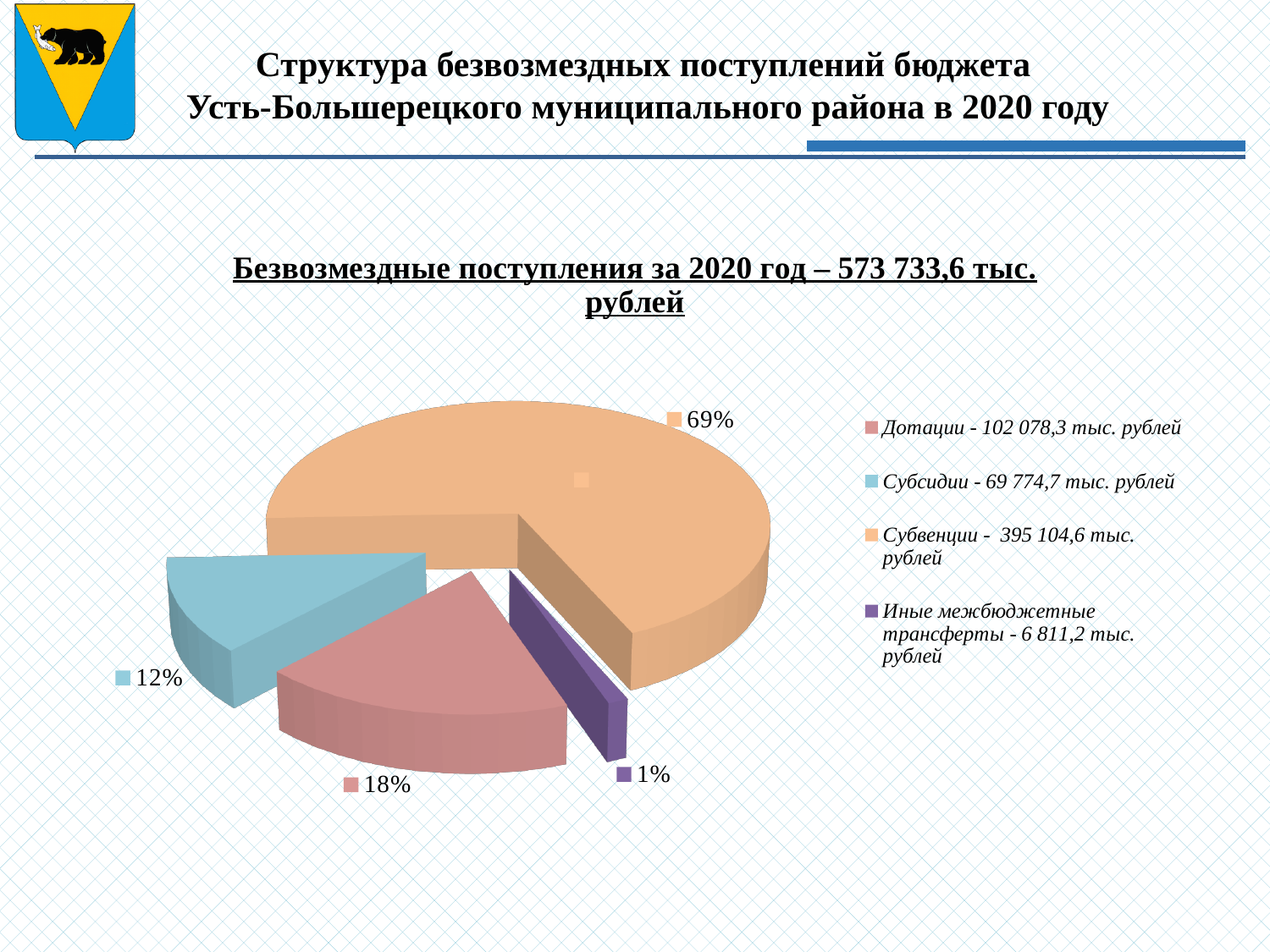
According to the legend, what is the value for Субсидии? 69 774,7 тыс. рублей What share of the pie does Субсидии take? 12% How many slices does the pie chart have? 4 What share of the pie does Иные межбюджетные трансферты take? 1% Which category has the smallest slice of the pie? Иные межбюджетные трансферты What share of the pie does Субвенции take? 69% What kind of chart is shown on the slide? pie chart Which category has the largest slice of the pie? Субвенции What total amount of безвозмездные поступления for 2020 is stated in the chart title? 573 733,6 тыс. рублей Which slice is larger, Дотации or Субсидии? Дотации What is the difference in percentage points between the Субвенции slice and the Дотации slice? 51